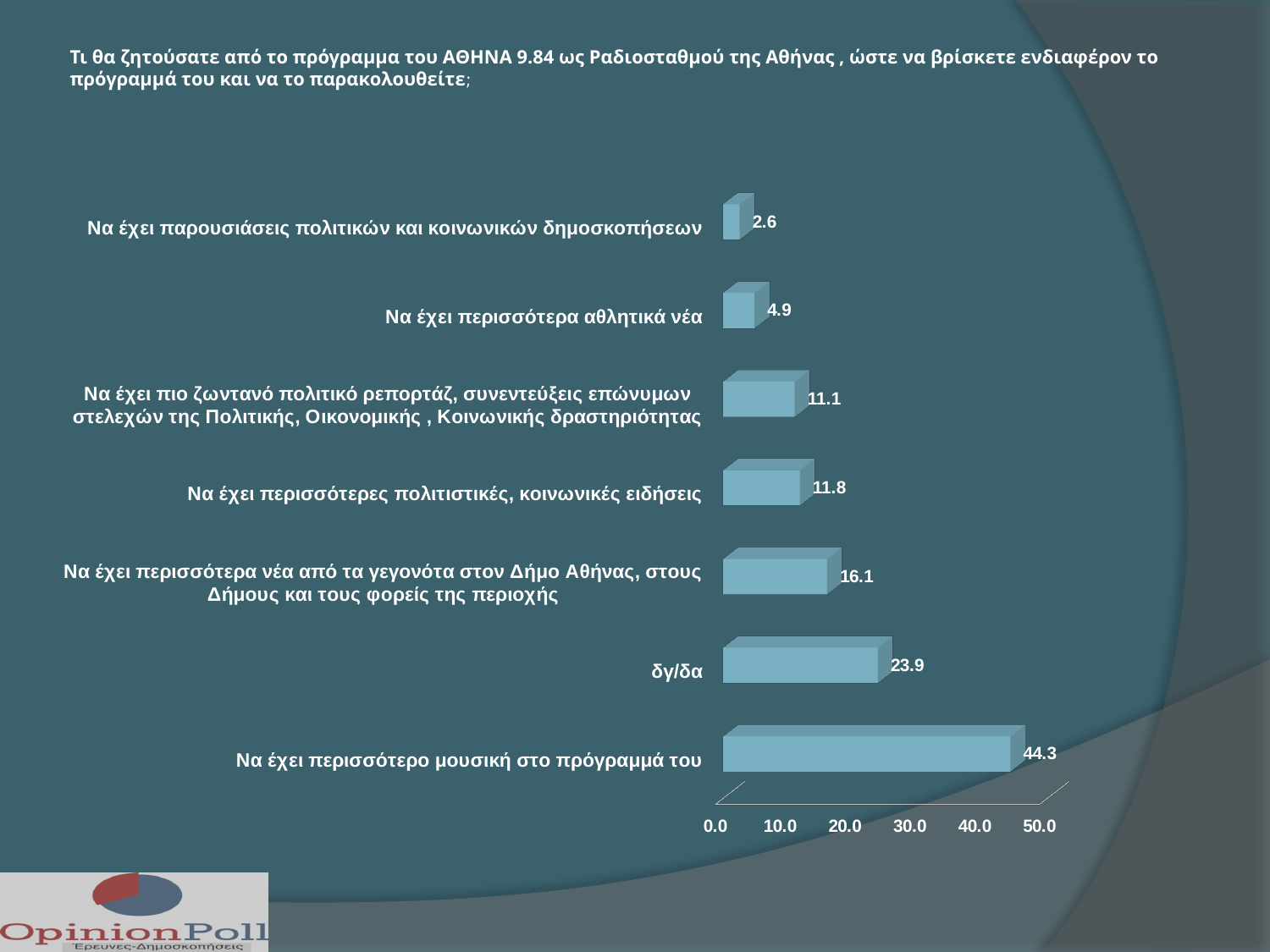
What kind of chart is shown on the slide? bar chart What is the value for 'Να έχει περισσότερο μουσική στο πρόγραμμά του'? 44.3 Which category has the lowest value? Να έχει παρουσιάσεις πολιτικών και κοινωνικών δημοσκοπήσεων What is the maximum value shown on the horizontal axis? 50.0 What is the value for 'δγ/δα'? 23.9 What is the difference between the values for 'Να έχει περισσότερο μουσική στο πρόγραμμά του' and 'δγ/δα'? 20.4 What is the value for 'Να έχει περισσότερα αθλητικά νέα'? 4.9 Which is larger: the value for 'Να έχει περισσότερα νέα από τα γεγονότα στον Δήμο Αθήνας, στους Δήμους και τους φορείς της περιοχής' or the value for 'Να έχει περισσότερες πολιτιστικές, κοινωνικές ειδήσεις'? Να έχει περισσότερα νέα από τα γεγονότα στον Δήμο Αθήνας, στους Δήμους και τους φορείς της περιοχής How many categories are shown in the chart? 7 What is the value for 'Να έχει περισσότερες πολιτιστικές, κοινωνικές ειδήσεις'? 11.8 Which category has the highest value? Να έχει περισσότερο μουσική στο πρόγραμμά του Is the value for 'δγ/δα' greater or less than 20.0? greater